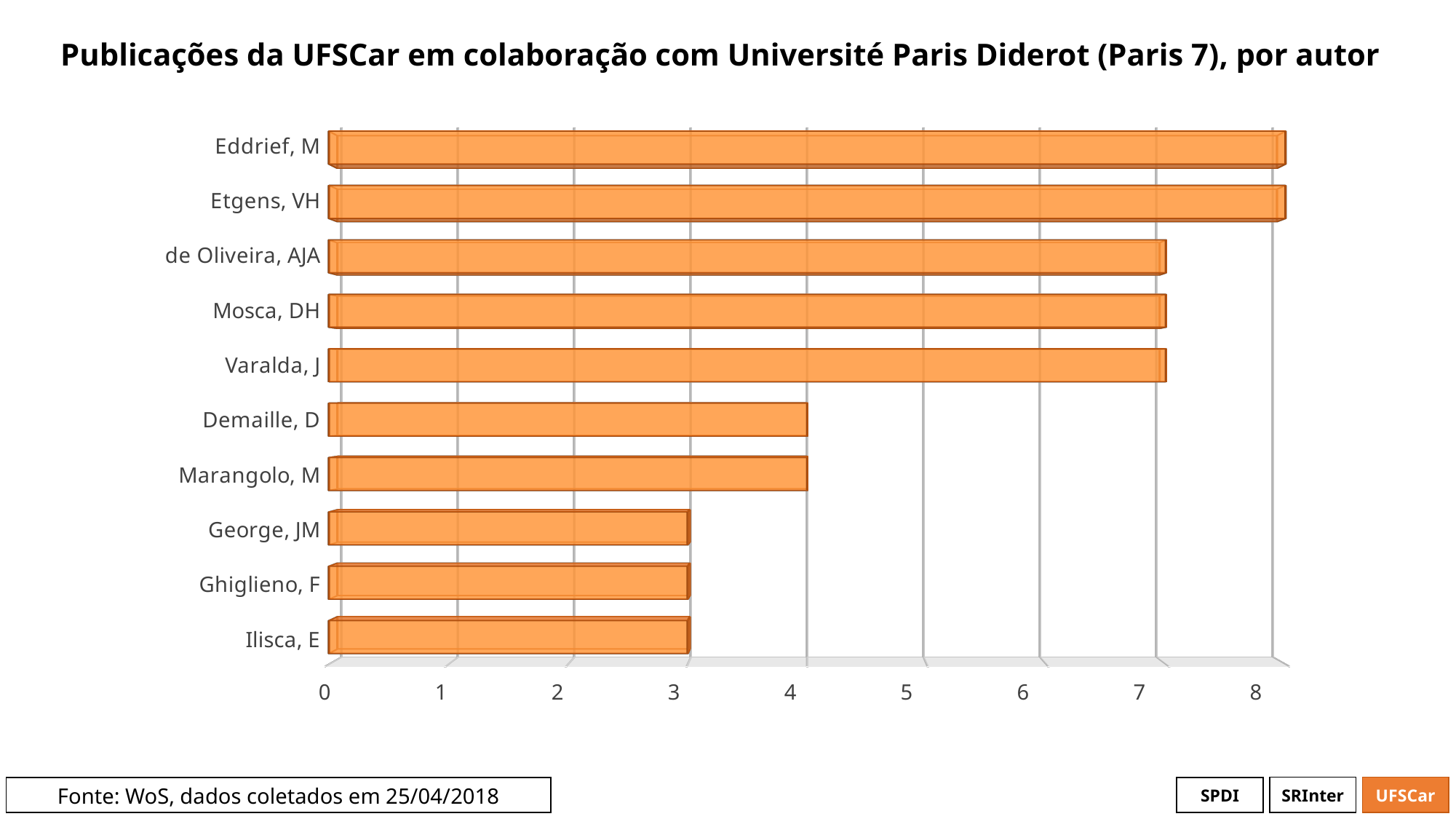
What is the source of the data stated on the slide? WoS, dados coletados em 25/04/2018 How many publications does the bar for Ilisca, E reach on the axis? 3 Which has more publications, Etgens, VH or Marangolo, M? Etgens, VH Is the value for Varalda, J greater or less than 6? greater How many publications does the bar for Mosca, DH reach on the axis? 7 What kind of chart is shown on the slide? bar chart How many publications does the bar for Eddrief, M reach on the axis? 8 How many publications does the bar for Demaille, D reach on the axis? 4 What is the difference in publications between Eddrief, M and Demaille, D? 4 How many authors are listed on the chart? 10 Is the value for George, JM greater or less than 4? less What is the title of the chart? Publicações da UFSCar em colaboração com Université Paris Diderot (Paris 7), por autor